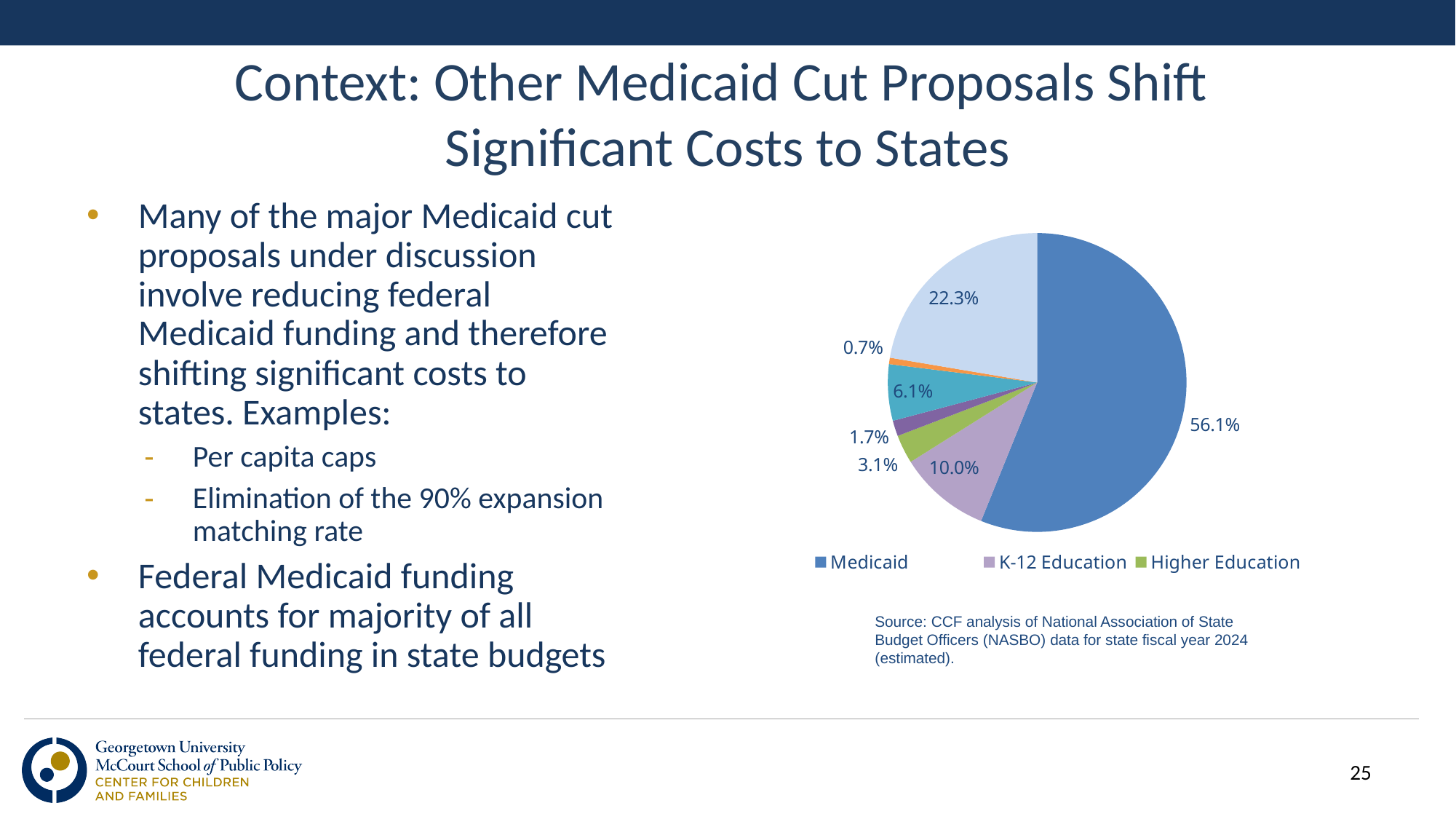
How many percentage points larger is the Medicaid slice than the K-12 Education slice? 46.1% What percentage is shown for Higher Education in the pie chart? 3.1% What kind of chart is shown on the slide? pie chart What colour is the Medicaid slice in the pie chart? blue What is the difference between the K-12 Education and Higher Education shares? 6.9% What percentage is shown for K-12 Education in the pie chart? 10.0% Which category has the largest slice of the pie chart? Medicaid What is the smallest percentage labeled on the pie chart? 0.7% How many categories are listed in the pie chart's legend? 3 What share of the pie chart does Medicaid account for? 56.1% Which slice is larger, K-12 Education or Higher Education? K-12 Education How many slices does the pie chart have? 7